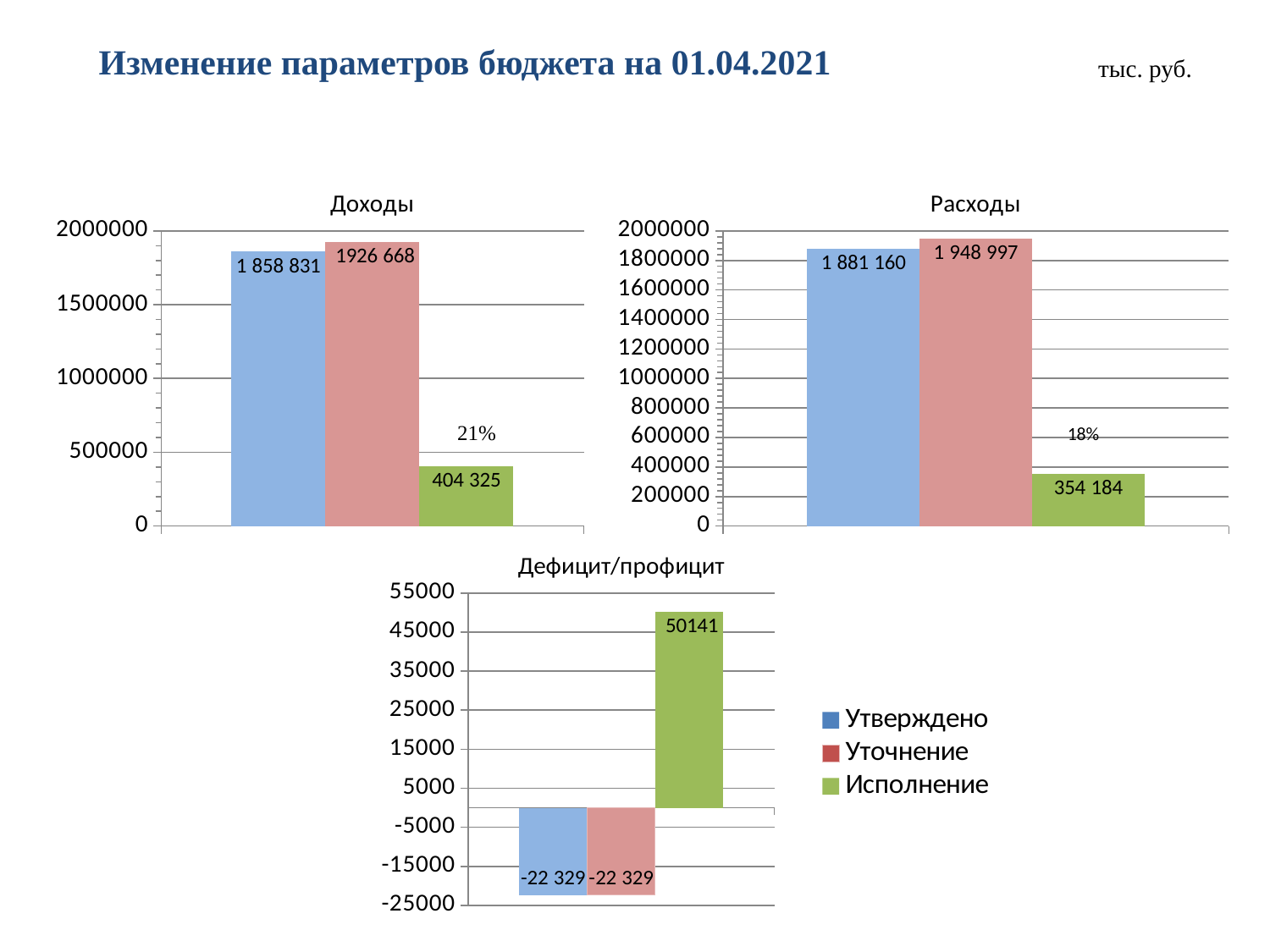
How many series does the legend list? 3 In the Расходы chart, what is the value for Исполнение? 354 184 In the Расходы chart, what is the difference between Уточнение and Утверждено? 67 837 In the Доходы chart, what is the value for Утверждено? 1 858 831 In the Доходы chart, what is the value for Исполнение? 404 325 In the Расходы chart, which series has the lowest value? Исполнение In the Дефицит/профицит chart, what is the value for Утверждено? -22 329 What kind of chart is the Дефицит/профицит chart? Bar chart In the Дефицит/профицит chart, what is the value for Исполнение? 50141 In the Доходы chart, which series has the highest value? Уточнение In the Доходы chart, which is larger, Утверждено or Уточнение? Уточнение In the Расходы chart, what is the value for Уточнение? 1 948 997